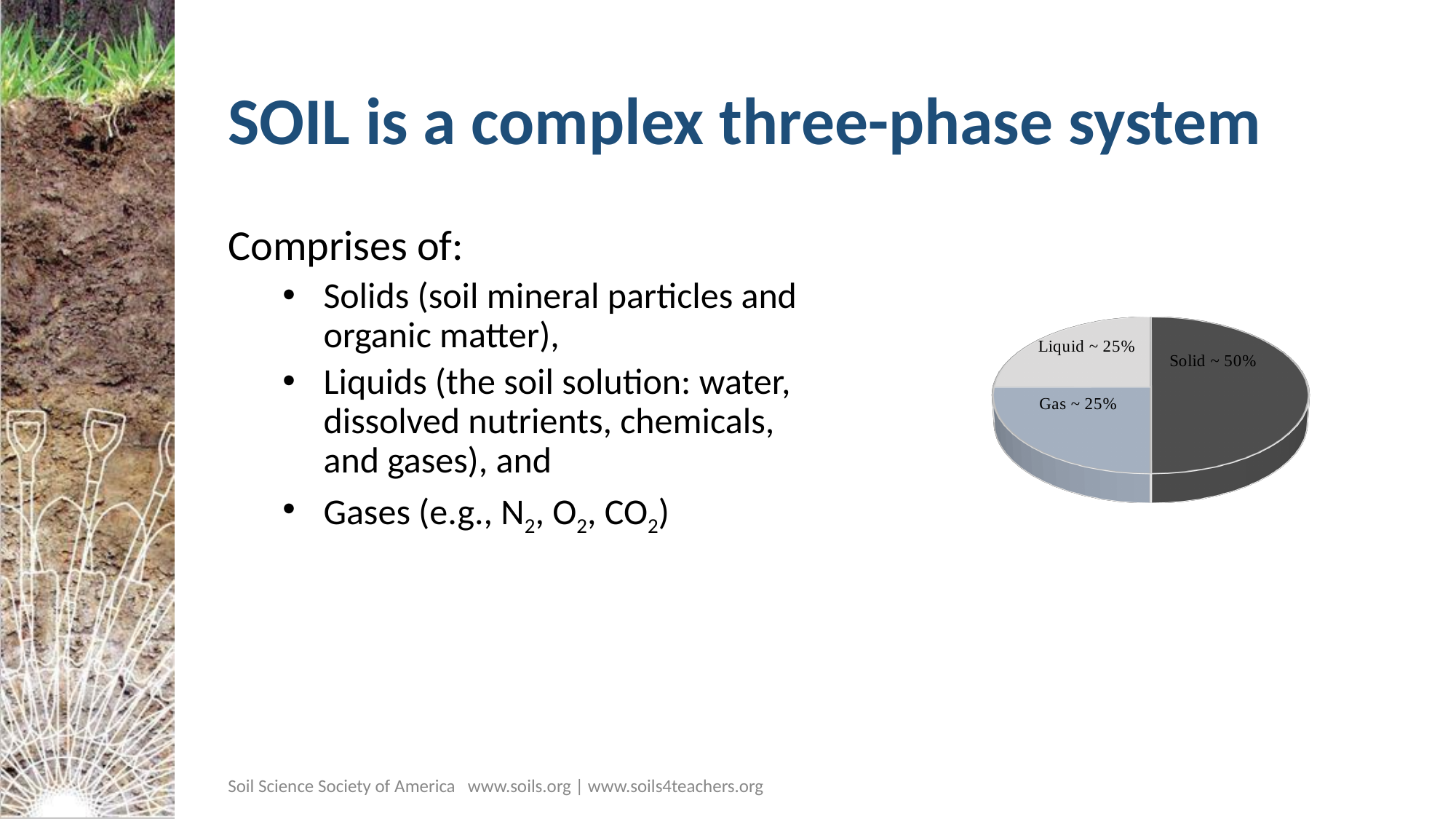
What share of the pie is labelled for Solid? ~ 50% What share of the pie is labelled for Gas? ~ 25% What share of the pie is labelled for Liquid? ~ 25% Which slice of the pie chart is the largest? Solid How many slices does the pie chart have? 3 What kind of chart is shown on the slide? pie chart Which slice of the pie chart is drawn in the darkest colour? Solid Which is larger in the pie chart, the Solid slice or the Liquid slice? Solid Which is larger in the pie chart, the Solid slice or the Gas slice? Solid What are the three categories shown in the pie chart? Solid, Liquid, Gas